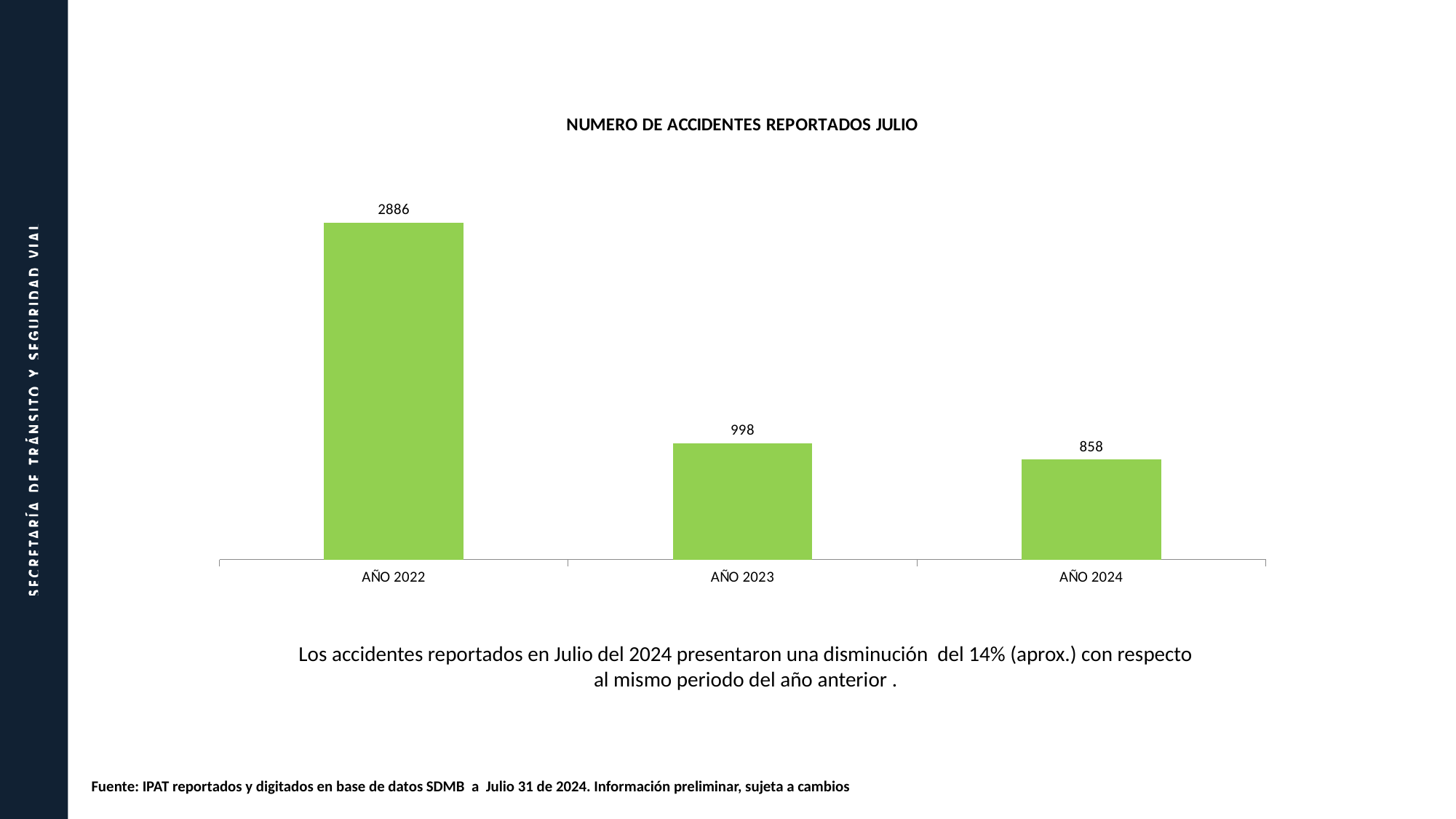
What is the number of accidents reported for AÑO 2022? 2886 What is the number of accidents reported for AÑO 2023? 998 What is the difference between the values for AÑO 2022 and AÑO 2023? 1888 Which year has the lowest number of accidents reported? AÑO 2024 What is the difference between the values for AÑO 2023 and AÑO 2024? 140 Do the values rise or fall from AÑO 2022 to AÑO 2024? Fall What is the number of accidents reported for AÑO 2024? 858 Which is larger, the value for AÑO 2023 or the value for AÑO 2024? AÑO 2023 Which year has the highest number of accidents reported? AÑO 2022 What is the title of the chart? NUMERO DE ACCIDENTES REPORTADOS JULIO What kind of chart is shown on the slide? Bar chart How many years are shown on the chart? 3